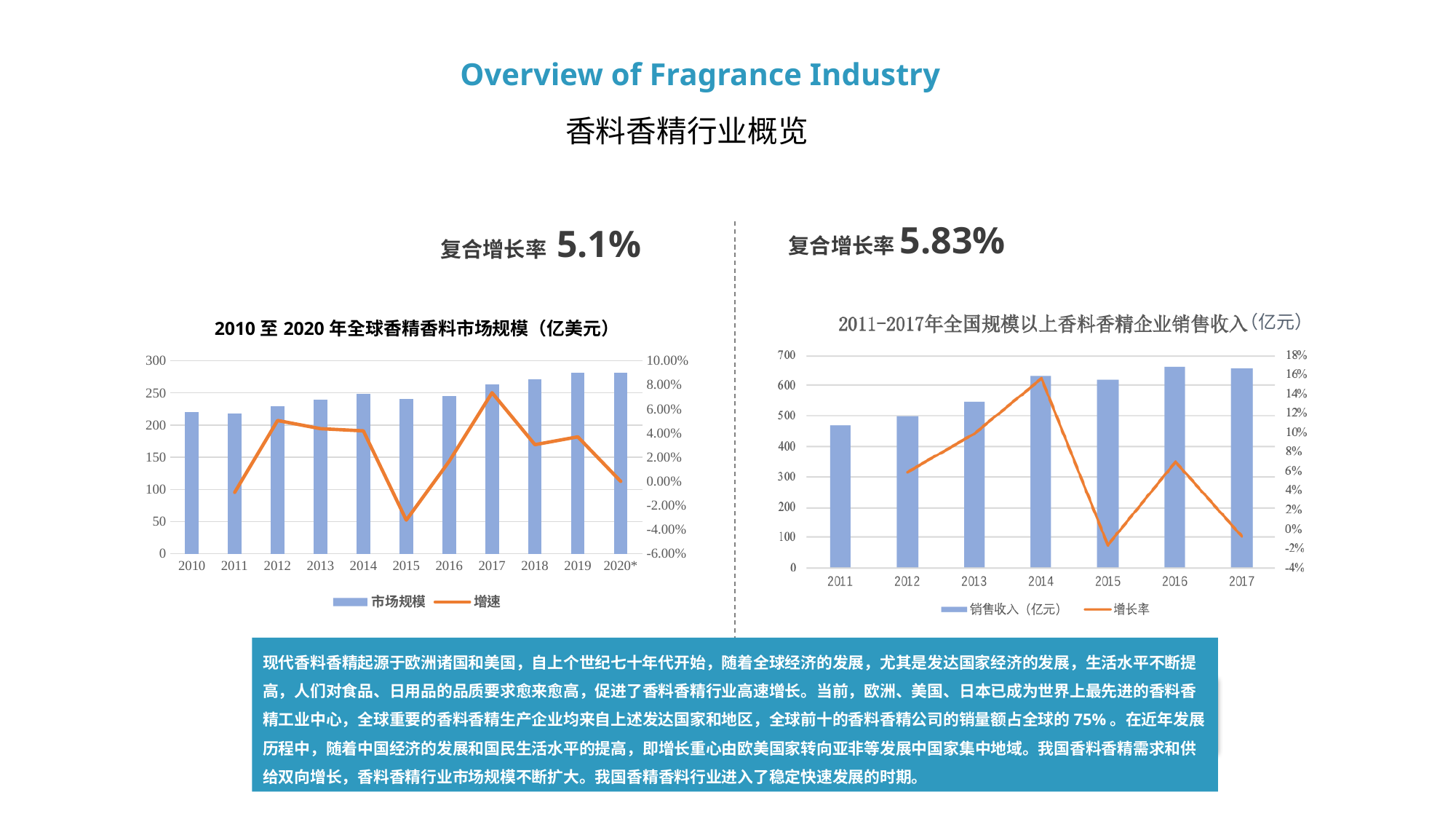
In the left chart, which is larger: the market size bar for 2017 or for 2013? 2017 What kind of chart is the right chart? Combined bar and line chart In the left chart (2010 至 2020 年全球香精香料市场规模), how many years are shown on the x axis? 11 In the left chart, which year has the highest growth rate (增速) on the line? 2017 In the right chart, is the sales revenue bar for 2016 greater or less than 600? greater In the right chart, which year has the lowest sales revenue bar? 2011 How many series does the legend of the left chart list? 2 In the left chart, is the market size bar for 2010 greater or less than 200? greater In the right chart, is the sales revenue bar for 2011 greater or less than 500? less In the right chart, which year has the lowest growth rate (增长率) on the line? 2015 In the right chart (2011-2017年全国规模以上香料香精企业销售收入), how many years are shown on the x axis? 7